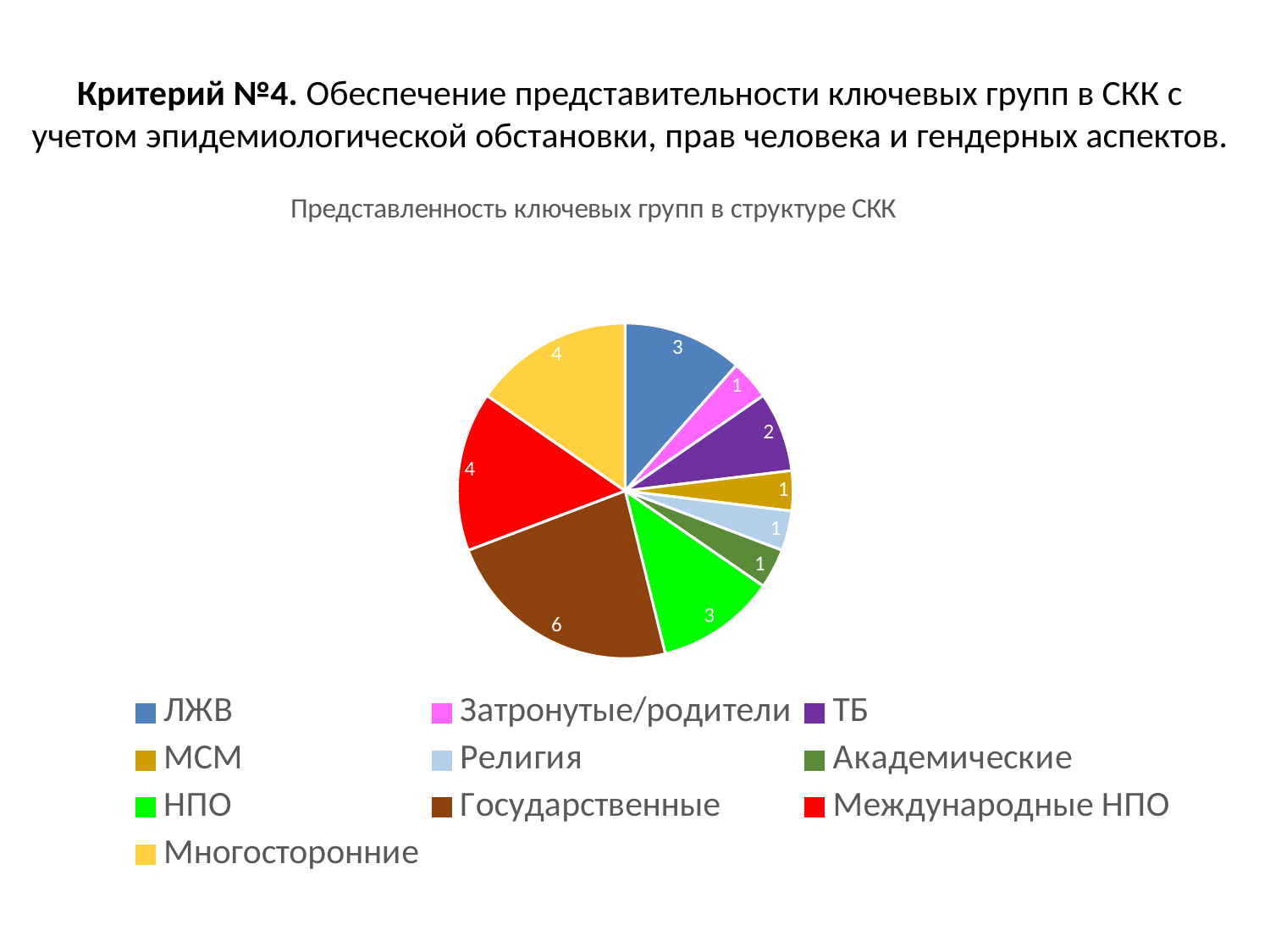
What is the title of the pie chart? Представленность ключевых групп в структуре СКК What is the value for ЛЖВ in the pie chart? 3 What is the value for МСМ in the pie chart? 1 What is the total of all the slice values in the pie chart? 26 Which is larger, the value for Международные НПО or the value for ТБ? Международные НПО What is the value for Государственные in the pie chart? 6 What is the value for ТБ in the pie chart? 2 What kind of chart is shown on the slide? pie chart Which category has the largest slice in the pie chart? Государственные What is the difference between the values for Государственные and ЛЖВ? 3 How many categories does the pie chart have? 10 What is the value for Международные НПО in the pie chart? 4